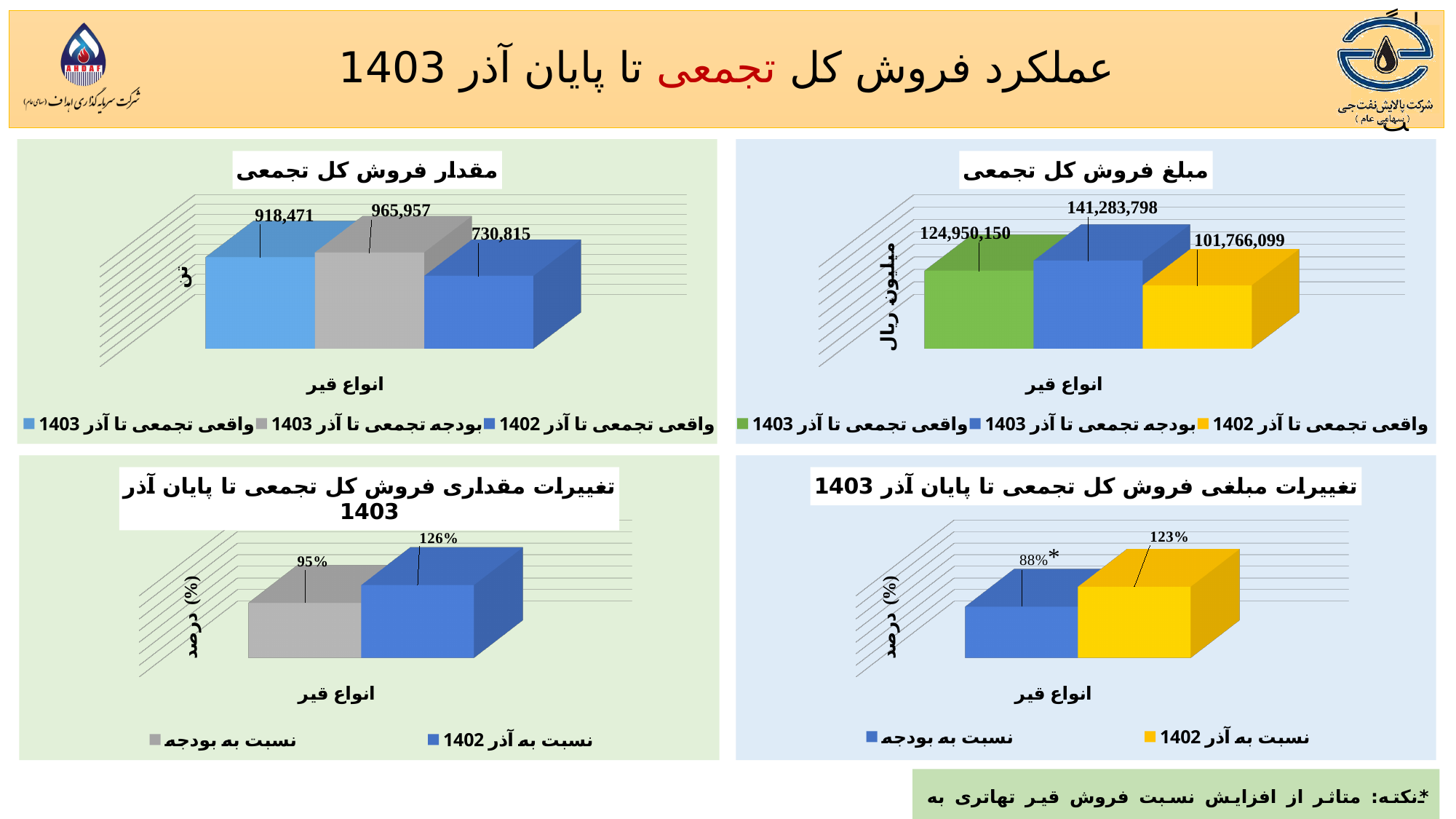
In the top-left chart (مقدار فروش کل تجمعی), what is the value for بودجه تجمعی تا آذر 1403? 965,957 What kind of chart is the bottom-right chart (تغییرات مبلغی فروش کل تجمعی تا پایان آذر 1403)? Bar chart In the top-right chart (مبلغ فروش کل تجمعی), which series has the highest value? بودجه تجمعی تا آذر 1403 In the top-right chart (مبلغ فروش کل تجمعی), what is the value for بودجه تجمعی تا آذر 1403? 141,283,798 In the bottom-right chart (تغییرات مبلغی فروش کل تجمعی تا پایان آذر 1403), what is the value for نسبت به بودجه? 88% In the top-left chart (مقدار فروش کل تجمعی), what is the value for واقعی تجمعی تا آذر 1403? 918,471 In the bottom-left chart (تغییرات مقداری فروش کل تجمعی تا پایان آذر 1403), which is larger: نسبت به بودجه or نسبت به آذر 1402? نسبت به آذر 1402 In the bottom-left chart (تغییرات مقداری فروش کل تجمعی تا پایان آذر 1403), what is the value for نسبت به آذر 1402? 126% In the top-left chart (مقدار فروش کل تجمعی), which series has the lowest value? واقعی تجمعی تا آذر 1402 In the top-left chart (مقدار فروش کل تجمعی), what is the difference between بودجه تجمعی تا آذر 1403 and واقعی تجمعی تا آذر 1403? 47,486 In the top-right chart (مبلغ فروش کل تجمعی), what is the value for واقعی تجمعی تا آذر 1402? 101,766,099 In the top-right chart (مبلغ فروش کل تجمعی), how many series does the legend list? 3